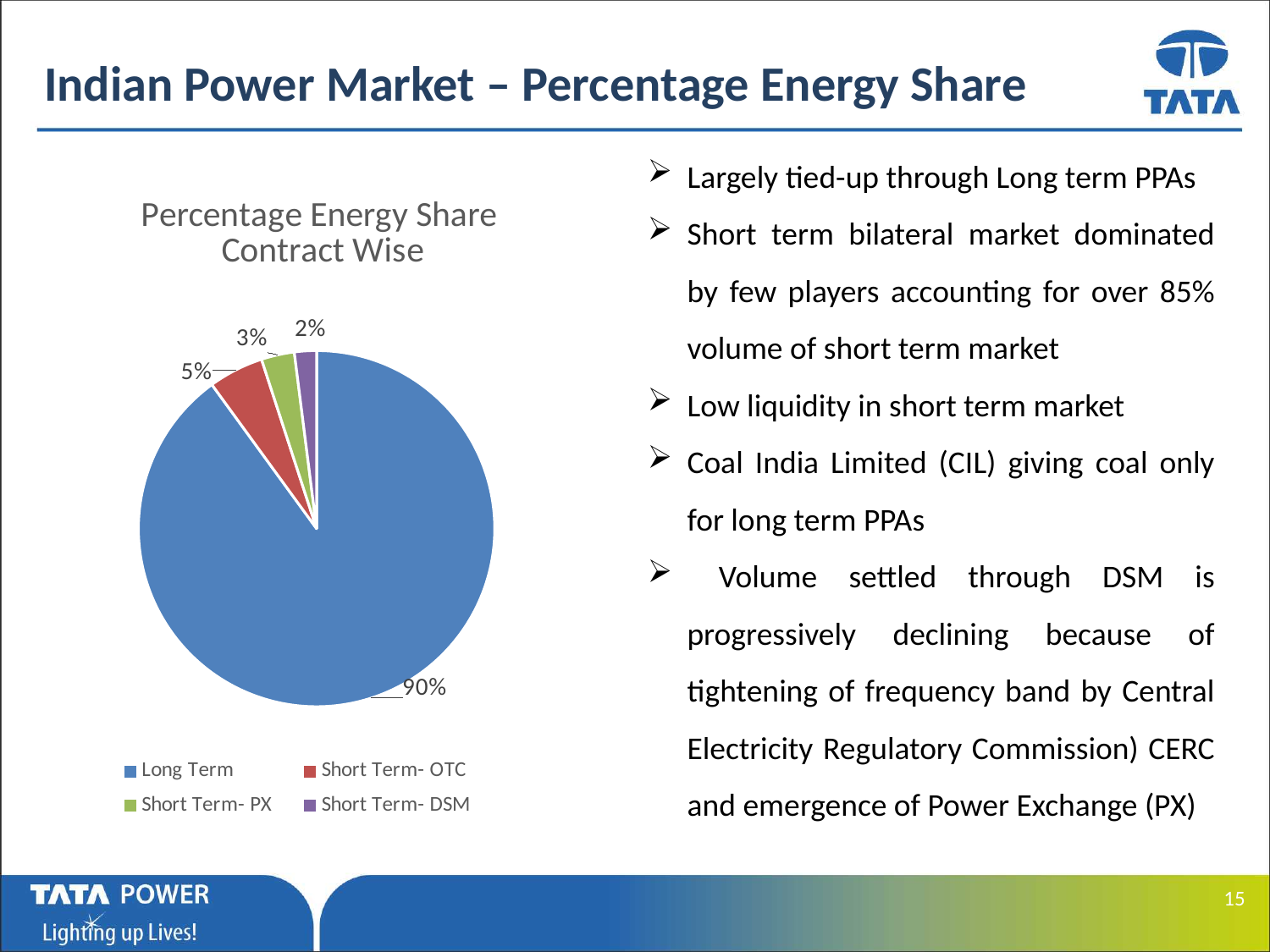
How many categories does the pie chart show? 4 What colour is the Long Term slice in the pie chart? Blue What share of the pie does Short Term- PX account for? 3% What is the difference in percentage points between Long Term and Short Term- OTC? 85 What is the title of the chart? Percentage Energy Share Contract Wise What share of the pie does Short Term- OTC account for? 5% What share of the pie does Long Term account for? 90% Which category has the smallest slice of the pie? Short Term- DSM What share of the pie does Short Term- DSM account for? 2% Which is larger, the share for Short Term- OTC or the share for Short Term- PX? Short Term- OTC What kind of chart is shown on the slide? Pie chart Which category has the largest slice of the pie? Long Term